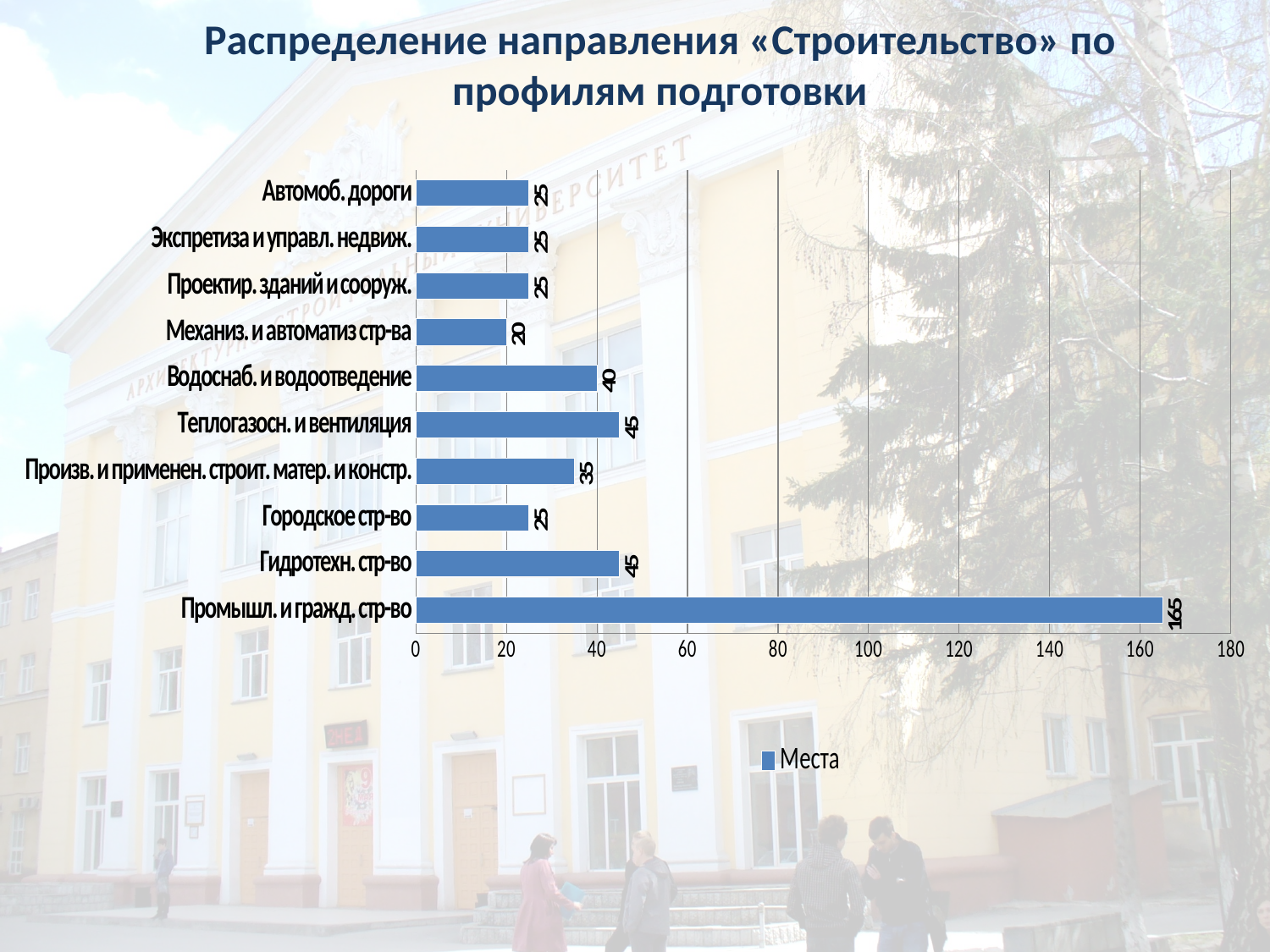
How many series does the legend list? 1 Is the value for Промышл. и гражд. стр-во greater or less than 160? greater What is the value for Механиз. и автоматиз стр-ва? 20 What kind of chart is shown on the slide? bar chart Which category has the lowest value? Механиз. и автоматиз стр-ва Which is larger: the value for Теплогазосн. и вентиляция or the value for Водоснаб. и водоотведение? Теплогазосн. и вентиляция How many categories are shown in the chart? 10 Which category has the highest value? Промышл. и гражд. стр-во What is the value for Промышл. и гражд. стр-во? 165 What is the value for Водоснаб. и водоотведение? 40 What is the difference between the values for Промышл. и гражд. стр-во and Гидротехн. стр-во? 120 What is the value for Произв. и применен. строит. матер. и констр.? 35